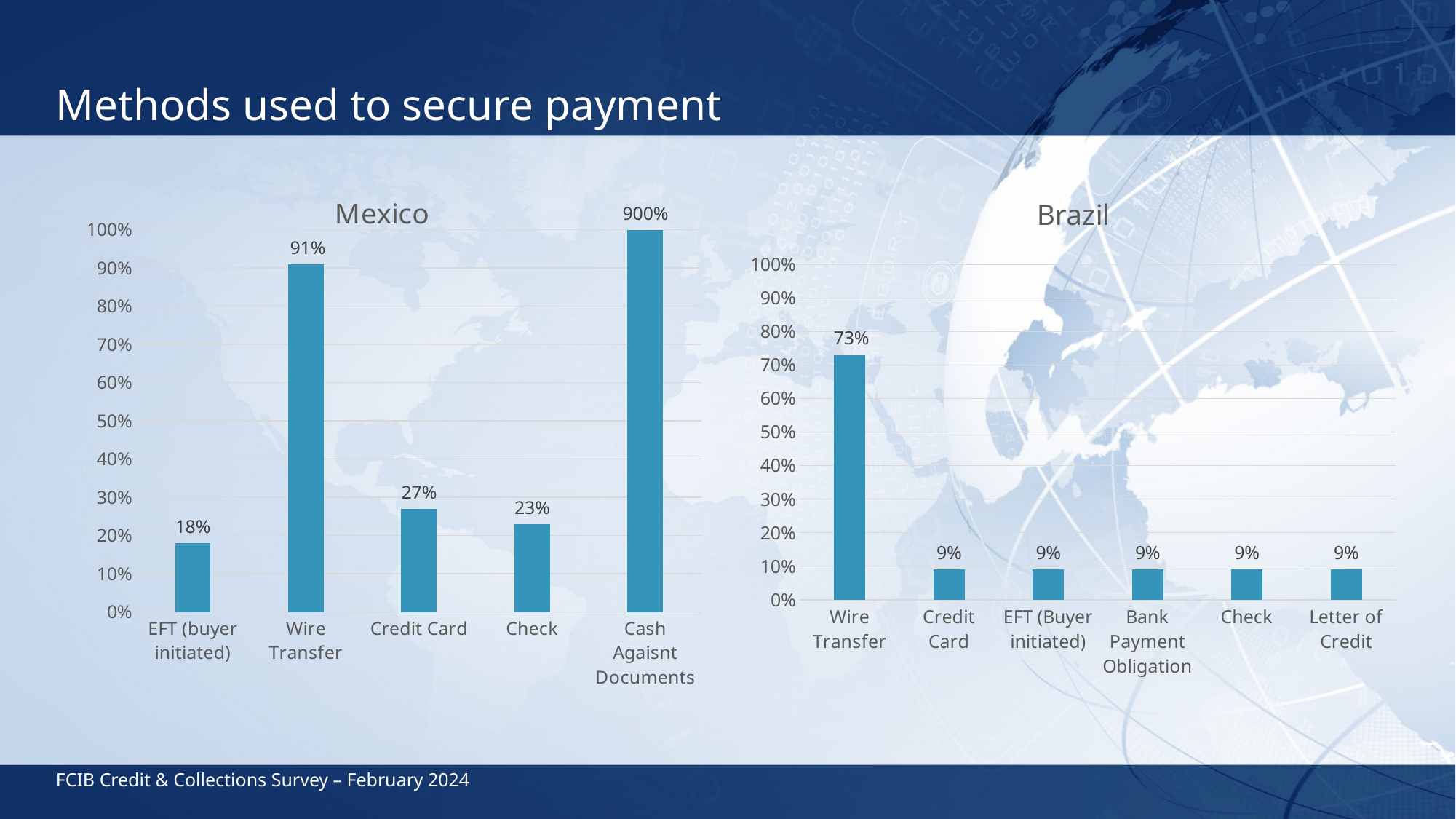
In the Mexico chart, what is the value for Wire Transfer? 91% In the Mexico chart, what data label is shown for Cash Against Documents? 900% In the Mexico chart, which category has the lowest value? EFT (buyer initiated) In the Brazil chart, what is the value for Letter of Credit? 9% How many categories are shown in the Brazil chart? 6 In the Brazil chart, which category has the highest value? Wire Transfer What kind of chart is the Mexico chart? Bar chart In the Brazil chart, what is the difference between Wire Transfer and Check? 64% In the Mexico chart, what is the difference between Wire Transfer and Credit Card? 64% In the Mexico chart, what is the value for EFT (buyer initiated)? 18% In the Mexico chart, which is larger, Credit Card or Check? Credit Card In the Brazil chart, what is the value for Wire Transfer? 73%